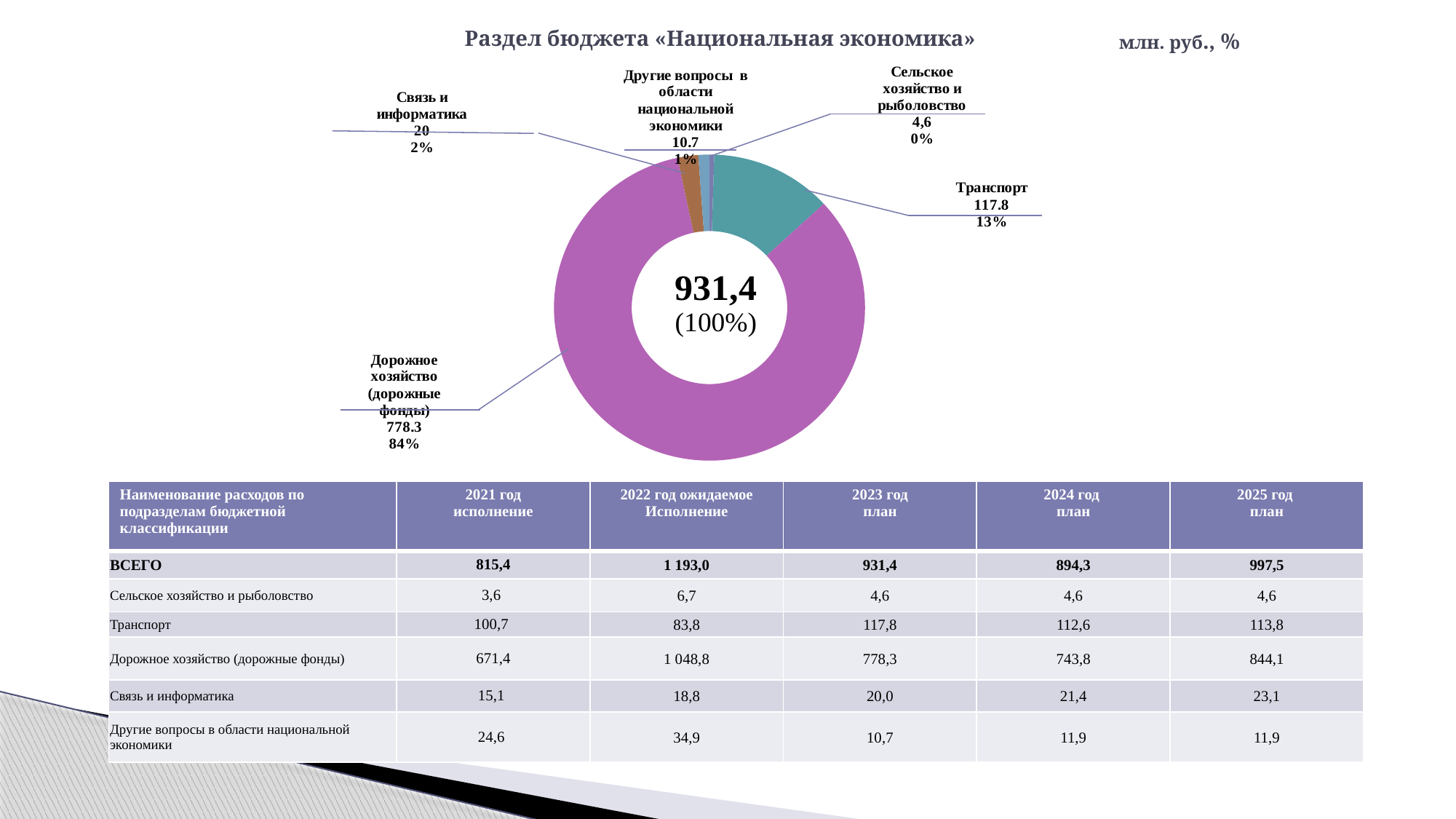
What share of the chart does Дорожное хозяйство (дорожные фонды) represent? 84% What is the value shown for Дорожное хозяйство (дорожные фонды) in the chart? 778.3 What type of chart is shown on the slide? Pie (donut) chart Which category has the smallest slice in the chart? Сельское хозяйство и рыболовство Which category has the largest slice in the chart? Дорожное хозяйство (дорожные фонды) What is the value shown for Связь и информатика in the chart? 20 What total value is shown in the centre of the chart? 931,4 What is the value shown for Транспорт in the chart? 117.8 What share of the chart does Транспорт represent? 13% What is the difference between the values for Транспорт and Связь и информатика in the chart? 97.8 What is the value shown for Сельское хозяйство и рыболовство in the chart? 4,6 How many categories are shown in the chart? 5